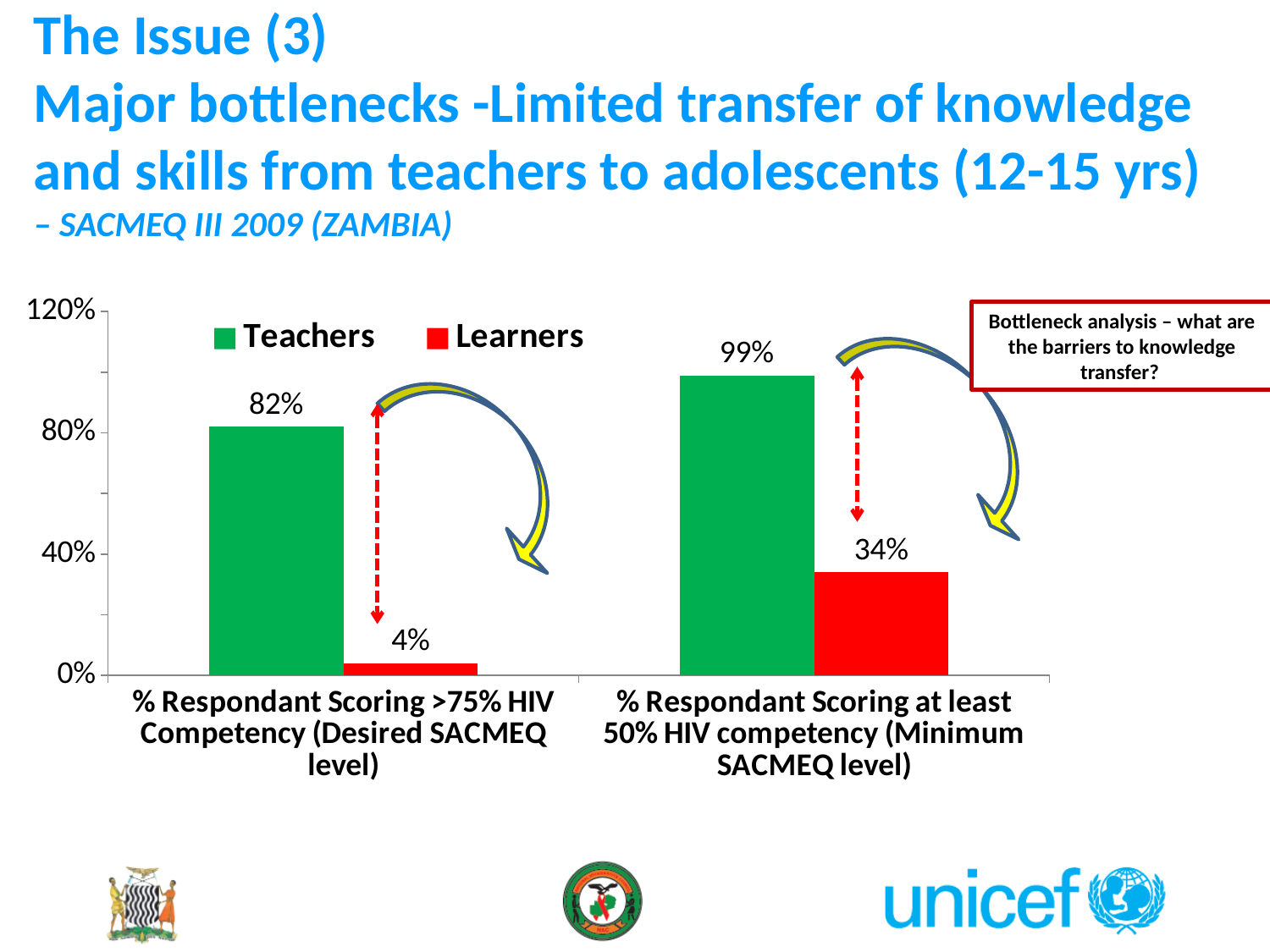
Which bar shows the lowest value on the chart? Learners, % Respondant Scoring >75% HIV Competency (Desired SACMEQ level) What percentage of teachers scored at least 50% HIV competency (Minimum SACMEQ level)? 99% What kind of chart is shown on the slide? Bar chart What percentage of learners scored >75% HIV competency (Desired SACMEQ level)? 4% What is the difference between the Teachers and Learners values for % Respondant Scoring >75% HIV Competency (Desired SACMEQ level)? 78% What percentage of learners scored at least 50% HIV competency (Minimum SACMEQ level)? 34% What is the difference between the Teachers and Learners values for % Respondant Scoring at least 50% HIV competency (Minimum SACMEQ level)? 65% How many categories are shown on the x axis? 2 How many series does the legend list? 2 Which is larger: the Learners value for >75% HIV competency or the Learners value for at least 50% HIV competency? At least 50% HIV competency Which series has the highest value on the chart? Teachers What percentage of teachers scored >75% HIV competency (Desired SACMEQ level)? 82%